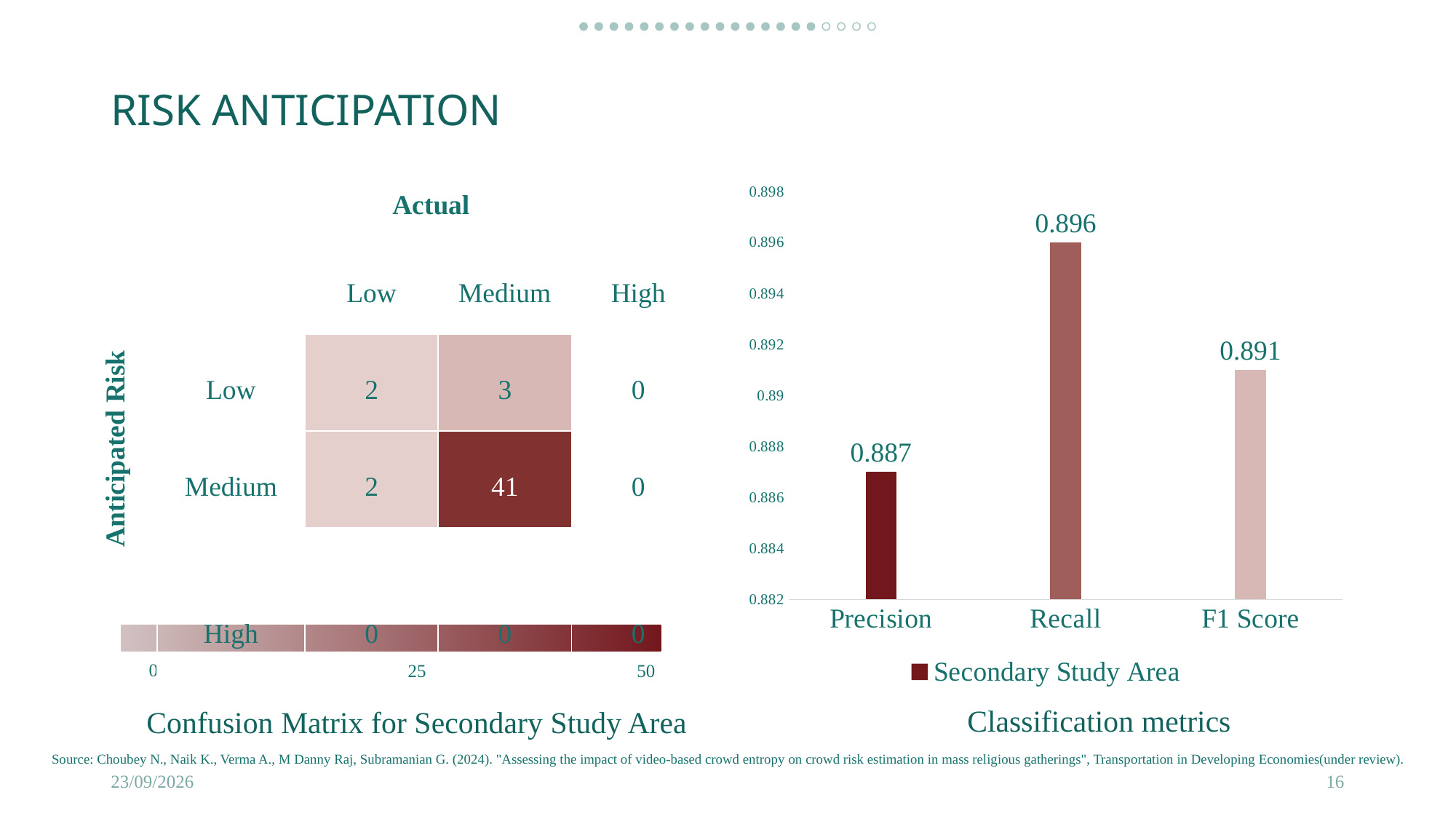
In the Classification metrics chart, what is the value for Precision? 0.887 In the Classification metrics chart, which is larger, F1 Score or Precision? F1 Score In the Classification metrics chart, what is the value for F1 Score? 0.891 In the Confusion Matrix for Secondary Study Area, what is the count for Anticipated Risk Medium and Actual Medium? 41 How many series does the legend of the Classification metrics chart list? 1 In the Classification metrics chart, which metric has the highest value? Recall In the Classification metrics chart, what is the difference between the Recall and Precision values? 0.009 In the Classification metrics chart, which metric has the lowest value? Precision In the Classification metrics chart, what is the value for Recall? 0.896 What kind of chart is the Classification metrics chart? bar chart In the Confusion Matrix for Secondary Study Area, what is the count for Anticipated Risk Low and Actual Medium? 3 How many metrics are plotted in the Classification metrics chart? 3